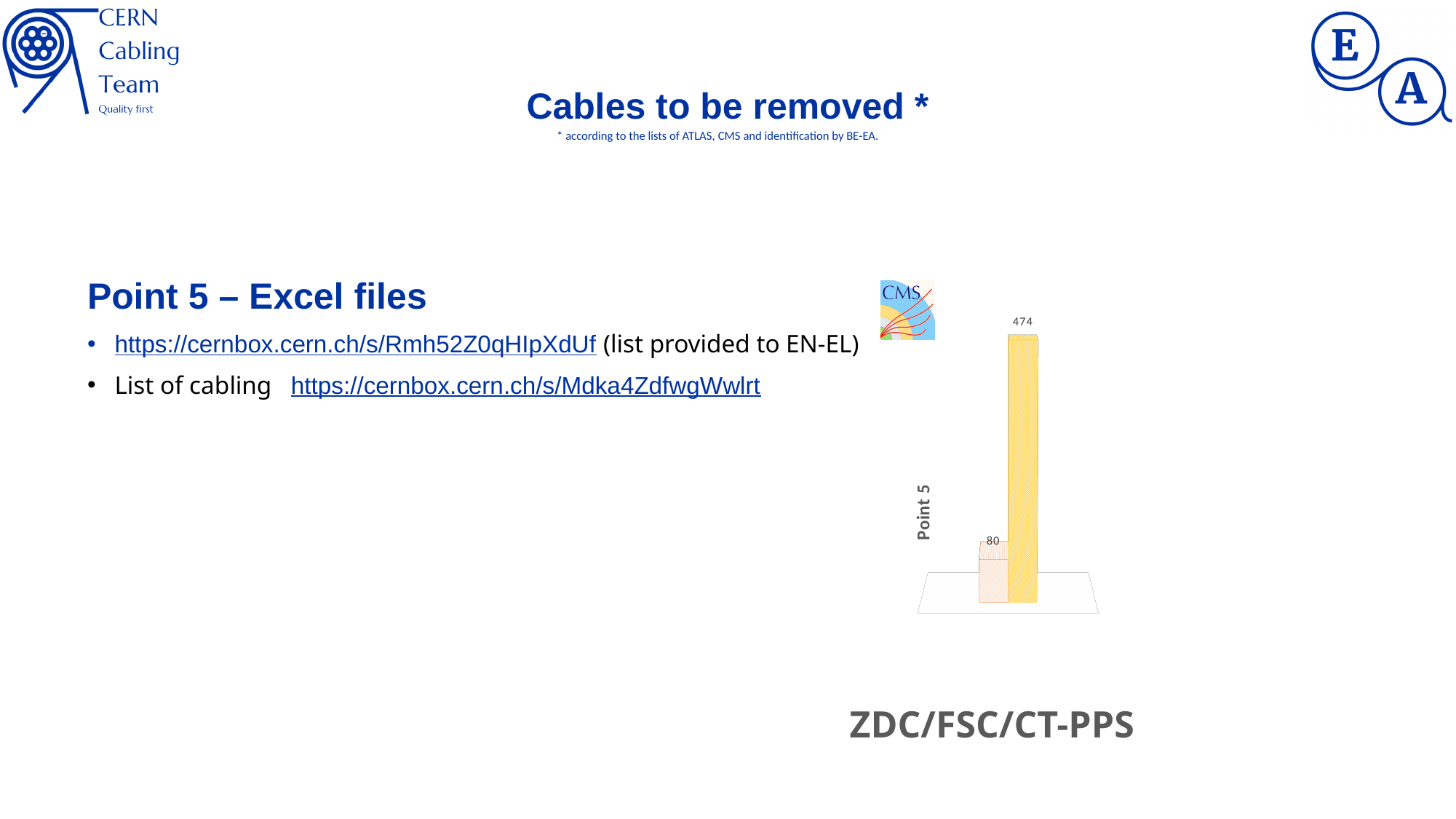
What category label appears below the chart? ZDC/FSC/CT-PPS Which bar is larger, the yellow bar or the orange bar? the yellow bar How many bars are plotted in the chart? 2 What is the difference between the two bar values, 474 and 80? 394 What is the highest value shown in the chart? 474 What kind of chart is shown on the slide? bar chart What is the vertical axis title of the chart? Point 5 What value is labelled on the tall yellow bar? 474 What value is labelled on the short orange bar? 80 What is the lowest value shown in the chart? 80